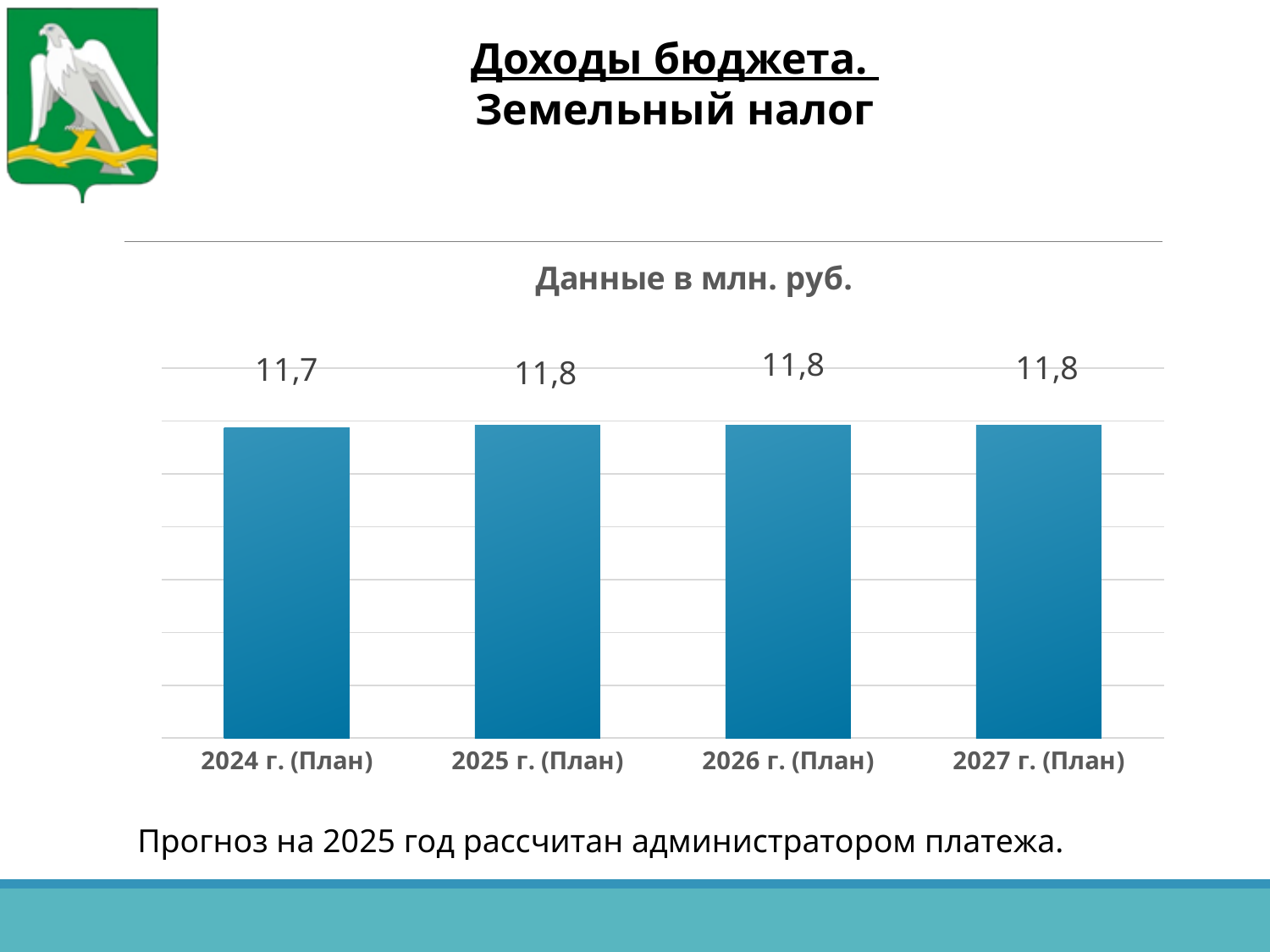
What is the difference between the values for 2025 г. (План) and 2024 г. (План)? 0,1 How many categories are shown on the chart? 4 What is the value for 2024 г. (План)? 11,7 What is the value for 2025 г. (План)? 11,8 What kind of chart is shown on the slide? bar chart What colour are the bars on the chart? blue What is the value for 2026 г. (План)? 11,8 Does the value rise or fall from 2024 г. (План) to 2025 г. (План)? rise What is the value for 2027 г. (План)? 11,8 What is the title of the chart? Данные в млн. руб. Which category has the lowest value? 2024 г. (План) Which is larger, the value for 2024 г. (План) or the value for 2025 г. (План)? 2025 г. (План)